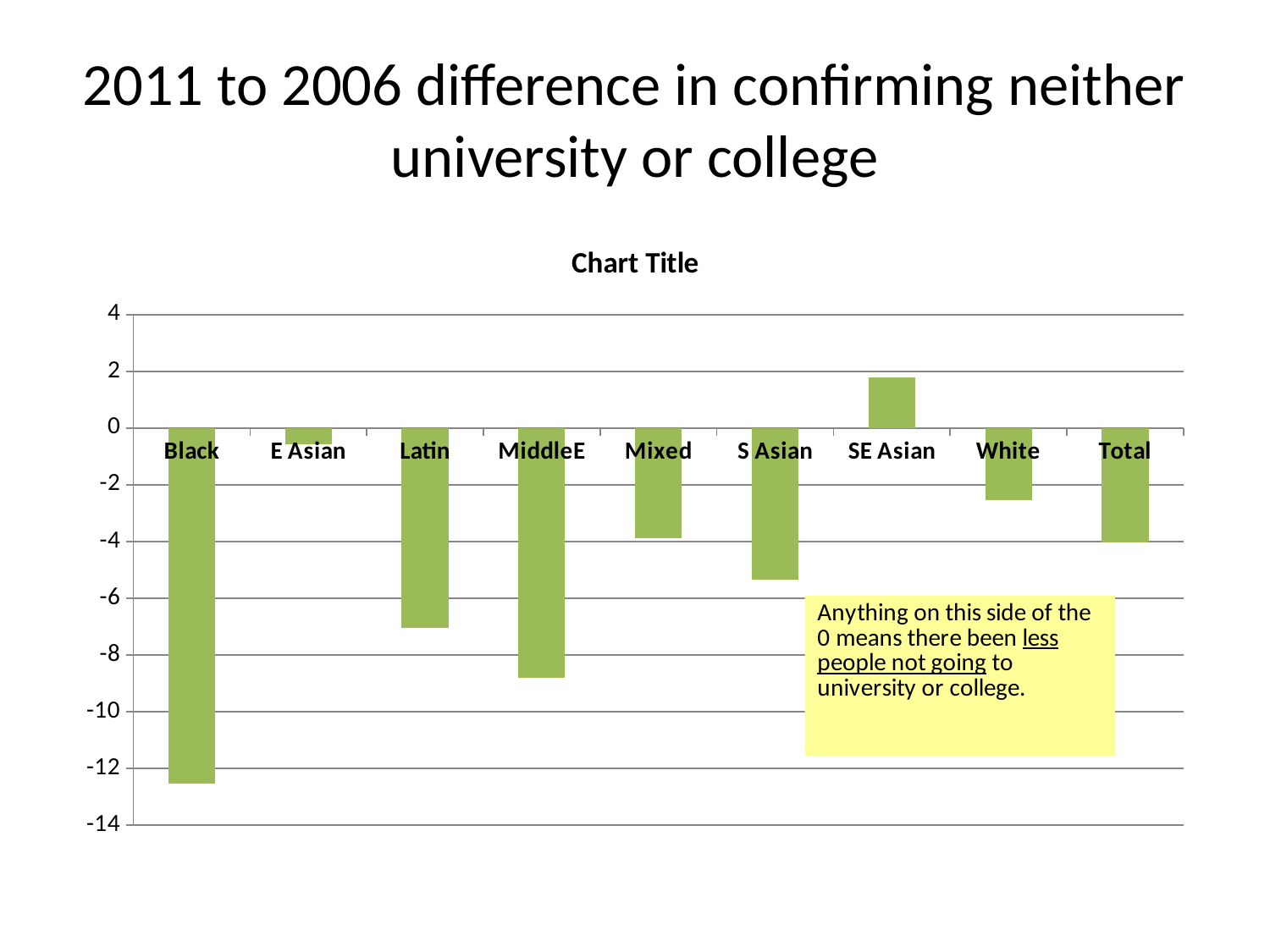
How many categories are shown on the x axis of the chart? 9 Is the value for SE Asian greater or less than 0? greater Which category has the highest value in the chart? SE Asian What is the title printed above the chart's plot area? Chart Title Which category has the lowest value in the chart? Black Is the value for White greater or less than -4? greater Which has the larger value, Mixed or S Asian? Mixed Is the value for Black greater or less than -12? less What kind of chart is shown on the slide? bar chart Which has the larger value, Latin or MiddleE? Latin